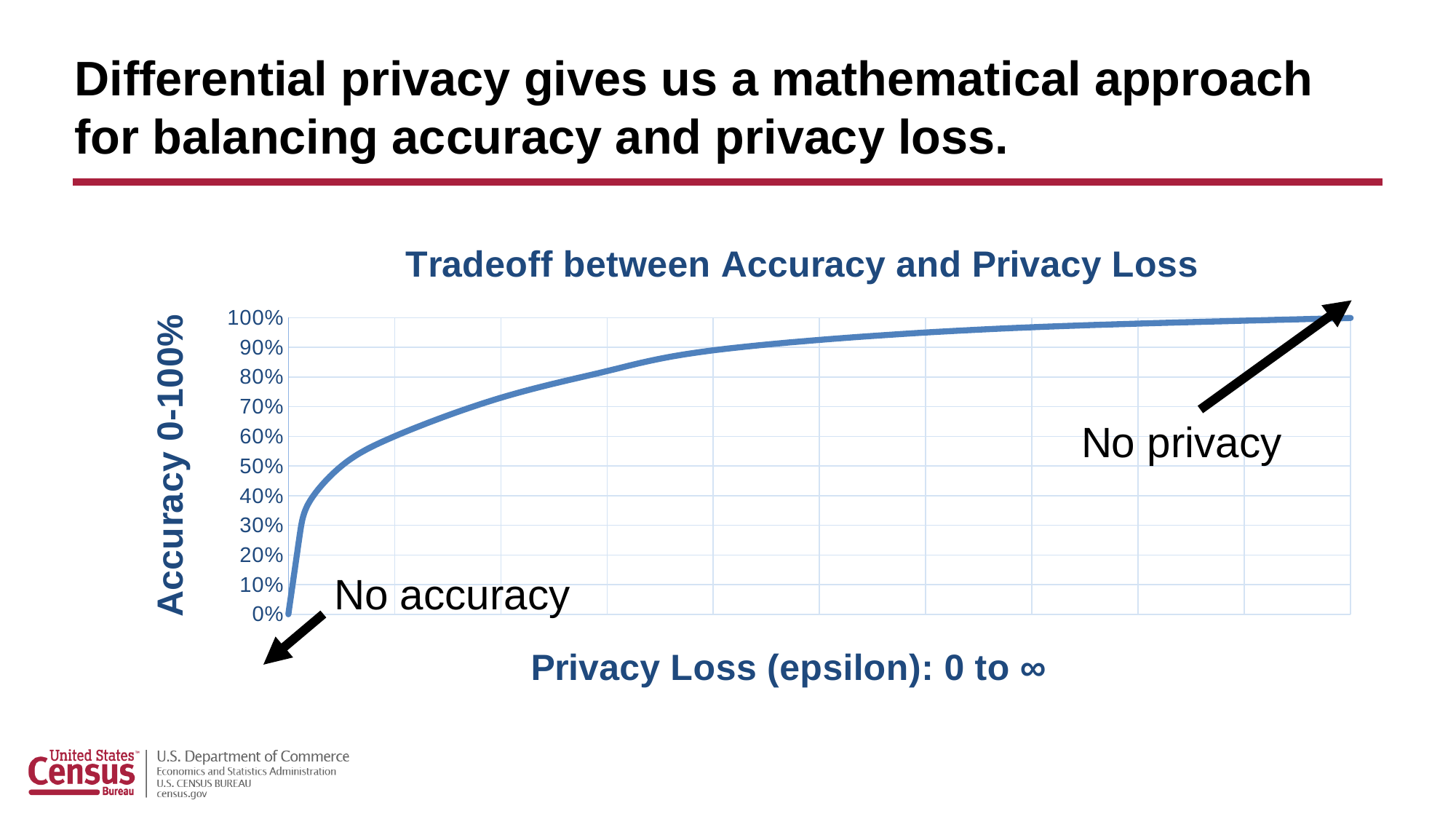
Does accuracy rise or fall as privacy loss increases along the x axis? Rise What is the label of the vertical axis of the chart? Accuracy 0-100% Which end of the curve has the higher accuracy, the left end or the right end? Right end Is the accuracy at the far left start of the curve greater or less than 10%? less What kind of chart is shown on the slide? Line chart What is the title of the chart? Tradeoff between Accuracy and Privacy Loss What is the highest value shown on the vertical axis of the chart? 100% Is the accuracy at the midpoint of the x axis greater or less than 80%? greater Is the accuracy at the far right end of the curve greater or less than 90%? greater What is the lowest value shown on the vertical axis of the chart? 0%